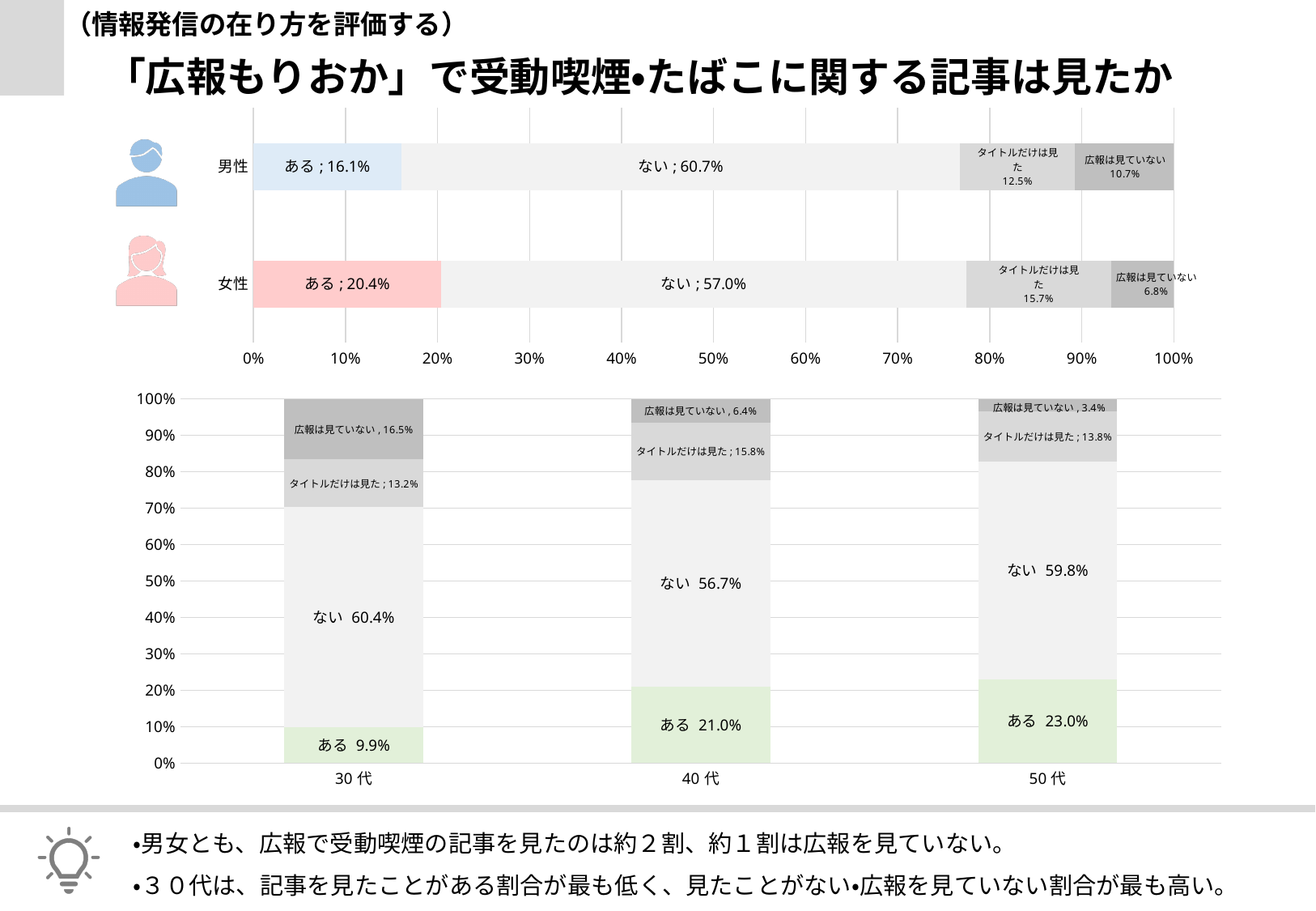
In the bottom chart (by age group), which age group has the highest ある value? 50代 In the bottom chart (by age group), which age group has the lowest 広報は見ていない value? 50代 In the bottom chart (by age group), what is the value of 広報は見ていない for 50代? 3.4% How many age groups are shown in the bottom chart? 3 In the top chart (by gender), which group has the larger ある value, 男性 or 女性? 女性 What kind of chart is the bottom chart (by age group)? Stacked bar chart In the top chart (by gender), what is the value of ない for 女性? 57.0% In the top chart (by gender), what is the value of 広報は見ていない for 男性? 10.7% In the top chart (by gender), what is the difference between the タイトルだけは見た values for 女性 and 男性? 3.2% In the bottom chart (by age group), what is the difference between the ない values for 30代 and 40代? 3.7% In the top chart (by gender), what is the value of ある for 男性? 16.1% In the bottom chart (by age group), what is the value of ある for 30代? 9.9%